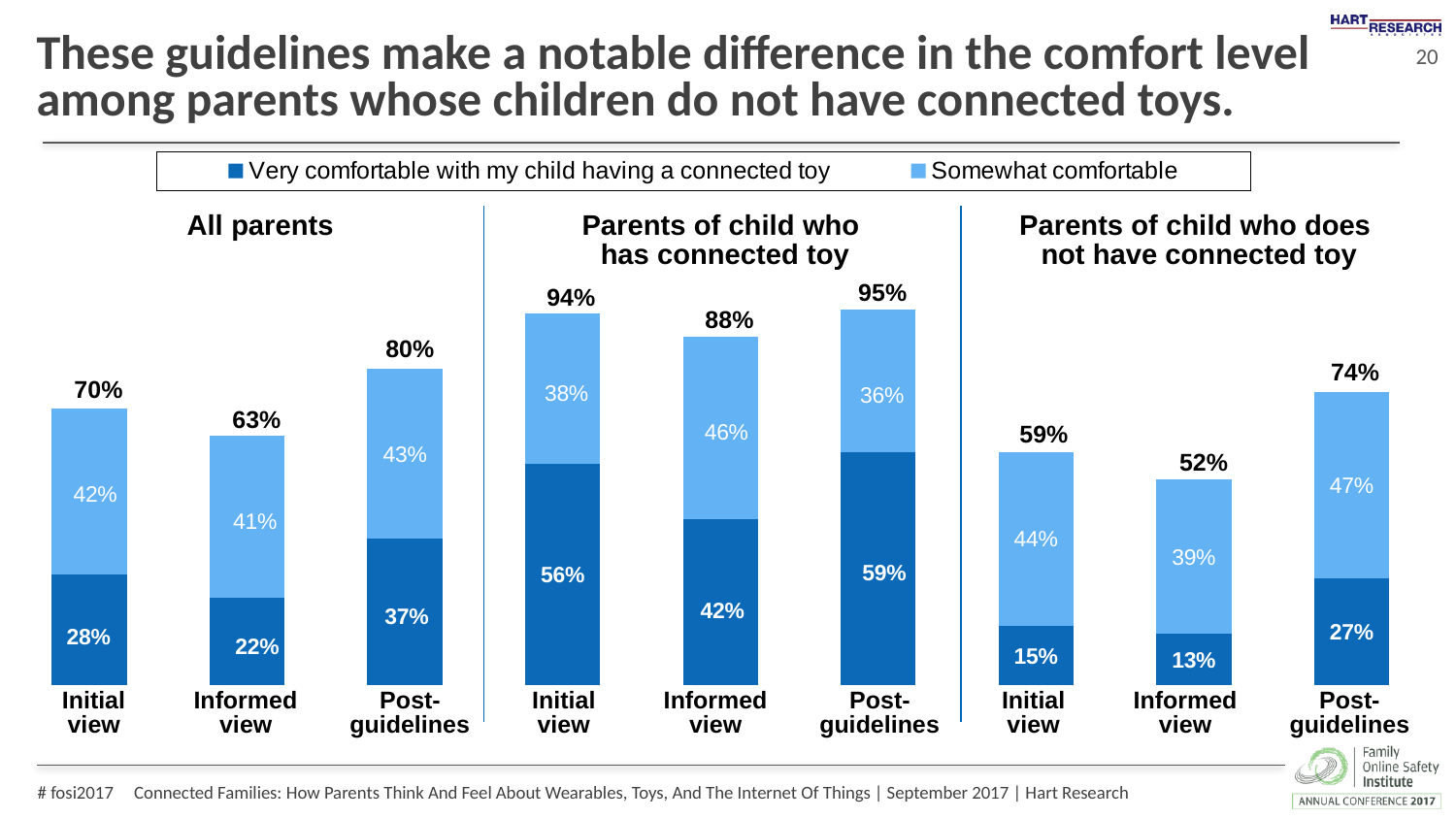
Which colour represents 'Somewhat comfortable' in the chart? Light blue In the 'Parents of child who does not have connected toy' group, what is the difference in the 'Very comfortable' share between Post-guidelines and Initial view? 12 percentage points In the 'Parents of child who does not have connected toy' group, what is the total comfort level shown above the Post-guidelines bar? 74% What kind of chart is shown on the slide? Stacked bar chart How many bars are plotted in total on the chart? 9 Which bar across the whole chart has the highest total? Post-guidelines for parents of child who has connected toy How many series does the legend list? 2 In the 'All parents' group, what is the difference between the Post-guidelines total and the Informed view total? 17 percentage points Which bar in the 'Parents of child who does not have connected toy' group has the lowest total? Informed view Is the 'Very comfortable' value for the Initial view larger in the 'Parents of child who has connected toy' group or the 'Parents of child who does not have connected toy' group? Parents of child who has connected toy In the 'Parents of child who has connected toy' group, what is the 'Somewhat comfortable' value for the Informed view? 46% In the 'All parents' group, what percentage is 'Very comfortable with my child having a connected toy' for the Initial view? 28%